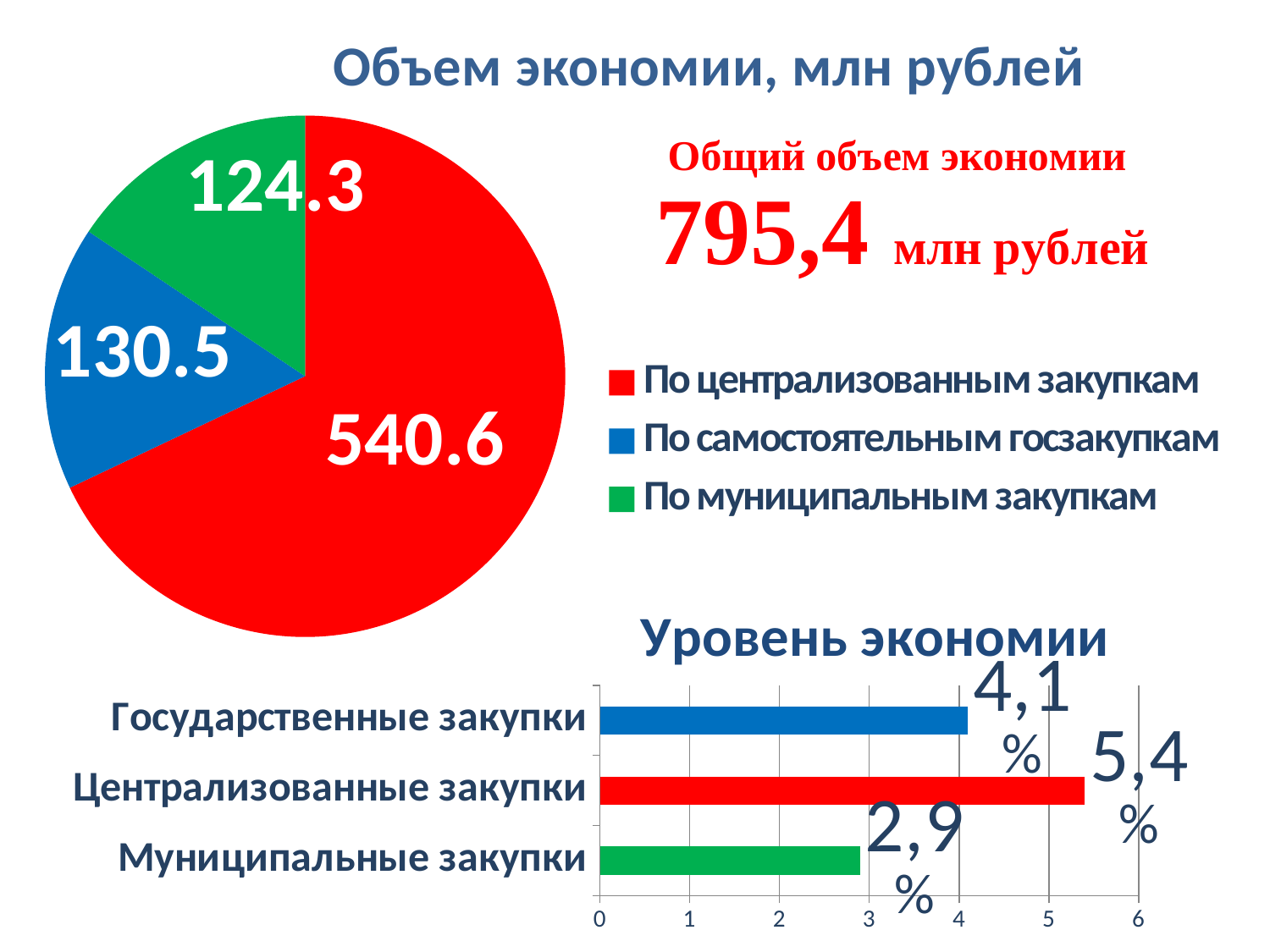
On the pie chart 'Объем экономии, млн рублей', which category has the largest slice? По централизованным закупкам On the pie chart 'Объем экономии, млн рублей', what is the difference between the values for 'По централизованным закупкам' and 'По самостоятельным госзакупкам'? 410.1 On the pie chart 'Объем экономии, млн рублей', what is the value for 'По централизованным закупкам'? 540.6 What kind of chart is 'Уровень экономии'? bar chart On the bar chart 'Уровень экономии', what is the value for 'Централизованные закупки'? 5,4% On the pie chart 'Объем экономии, млн рублей', what is the value for 'По самостоятельным госзакупкам'? 130.5 On the bar chart 'Уровень экономии', what is the difference between the values for 'Централизованные закупки' and 'Муниципальные закупки'? 2,5% On the bar chart 'Уровень экономии', what is the value for 'Муниципальные закупки'? 2,9% On the bar chart 'Уровень экономии', which category has the highest value? Централизованные закупки On the pie chart 'Объем экономии, млн рублей', which category has the smallest slice? По муниципальным закупкам On the pie chart 'Объем экономии, млн рублей', how many entries does the legend list? 3 On the pie chart 'Объем экономии, млн рублей', what is the value for 'По муниципальным закупкам'? 124.3